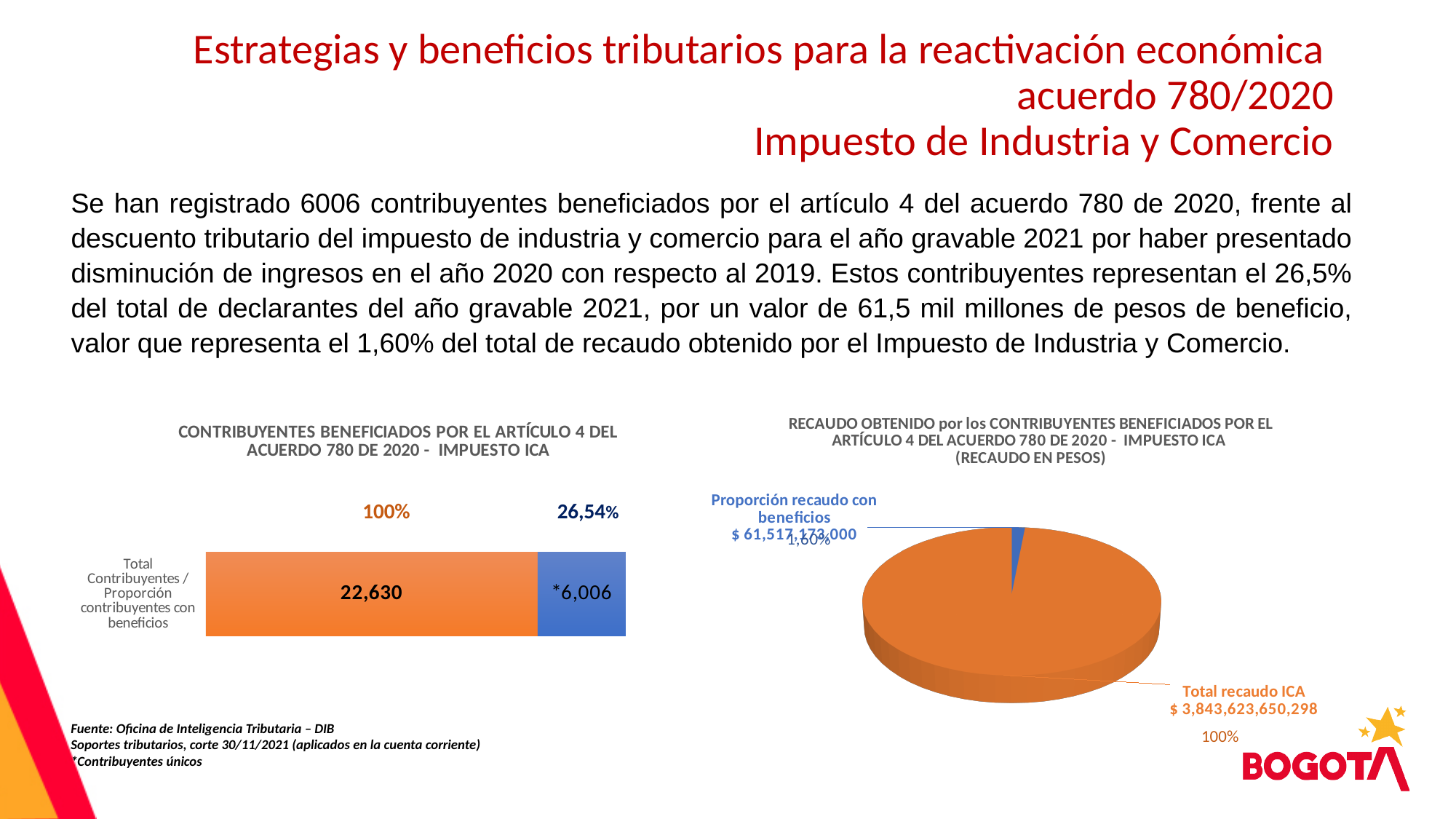
In the left bar chart, what colour is the segment labelled 22,630? orange What kind of chart is the right chart titled 'RECAUDO OBTENIDO por los CONTRIBUYENTES BENEFICIADOS POR EL ARTÍCULO 4 DEL ACUERDO 780 DE 2020 - IMPUESTO ICA'? pie chart In the left bar chart, what is the value shown for the contribuyentes con beneficios (blue segment)? 6,006 In the left bar chart, what is the value shown for the total contribuyentes (orange segment)? 22,630 In the right pie chart, which slice is larger: Total recaudo ICA or Proporción recaudo con beneficios? Total recaudo ICA In the left bar chart, which is larger: the total contribuyentes value or the contribuyentes con beneficios value? total contribuyentes (22,630) In the right pie chart, what is the value shown for Total recaudo ICA? $ 3,843,623,650,298 In the left bar chart, what percentage label appears above the blue segment? 26,54% In the right pie chart, what percentage is shown for Proporción recaudo con beneficios? 1,60% How many slices does the right pie chart have? 2 What kind of chart is the left chart titled 'CONTRIBUYENTES BENEFICIADOS POR EL ARTÍCULO 4 DEL ACUERDO 780 DE 2020 - IMPUESTO ICA'? bar chart In the left bar chart, what is the difference between the total contribuyentes (22,630) and the contribuyentes con beneficios (6,006)? 16,624